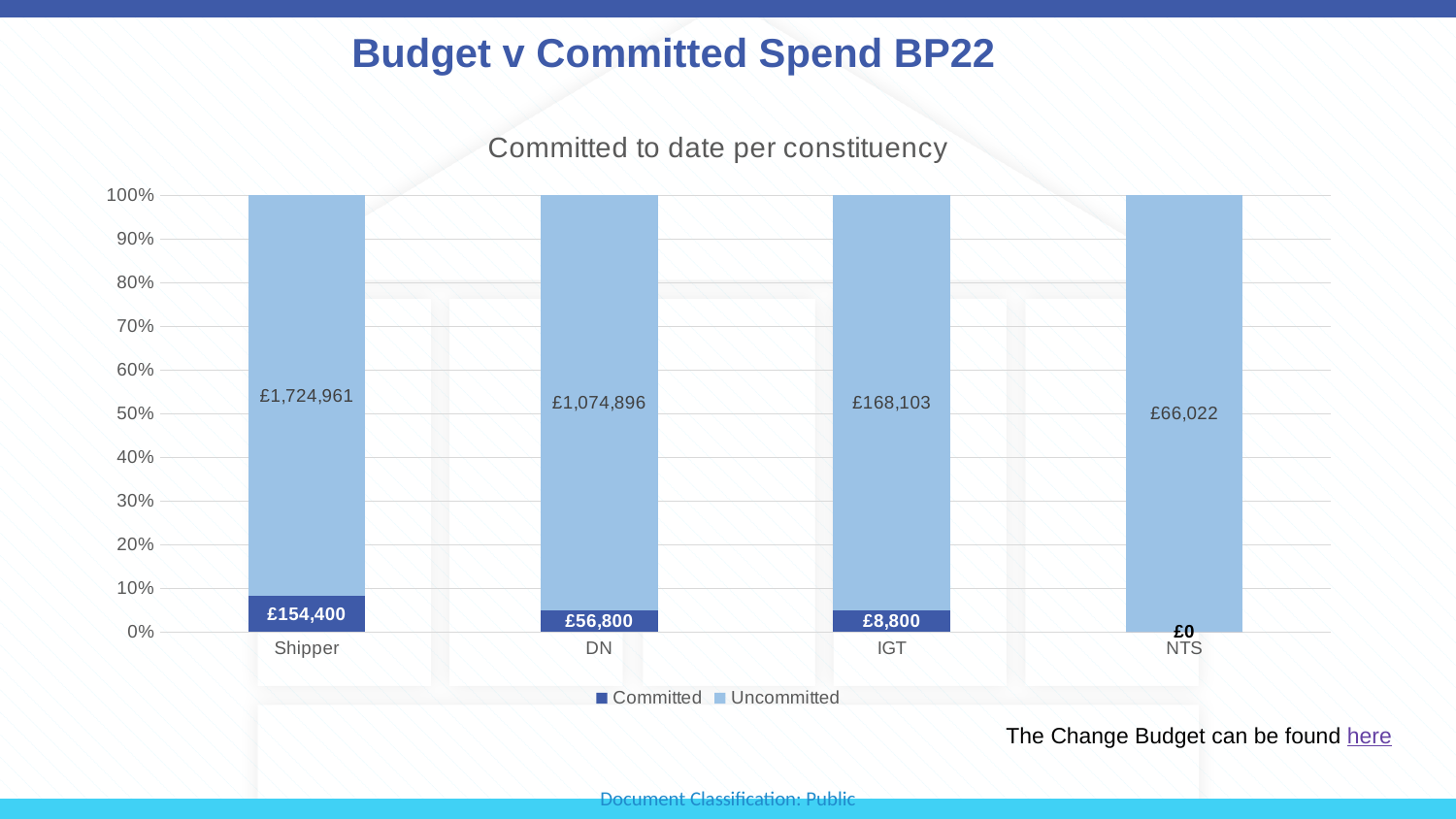
How many constituencies are shown on the x axis? 4 What kind of chart is shown? Stacked bar chart What is the Uncommitted value for IGT? £168,103 What is the Committed value for NTS? £0 What is the difference between the Committed values for Shipper and DN? £97,600 How many series does the legend list? 2 Which constituency has the highest Committed value? Shipper What is the total of the Committed and Uncommitted values for IGT? £176,903 Which is larger, the Uncommitted value for DN or the Uncommitted value for IGT? DN Which constituency has the lowest Uncommitted value? NTS What is the Committed value for Shipper? £154,400 What is the Uncommitted value for DN? £1,074,896